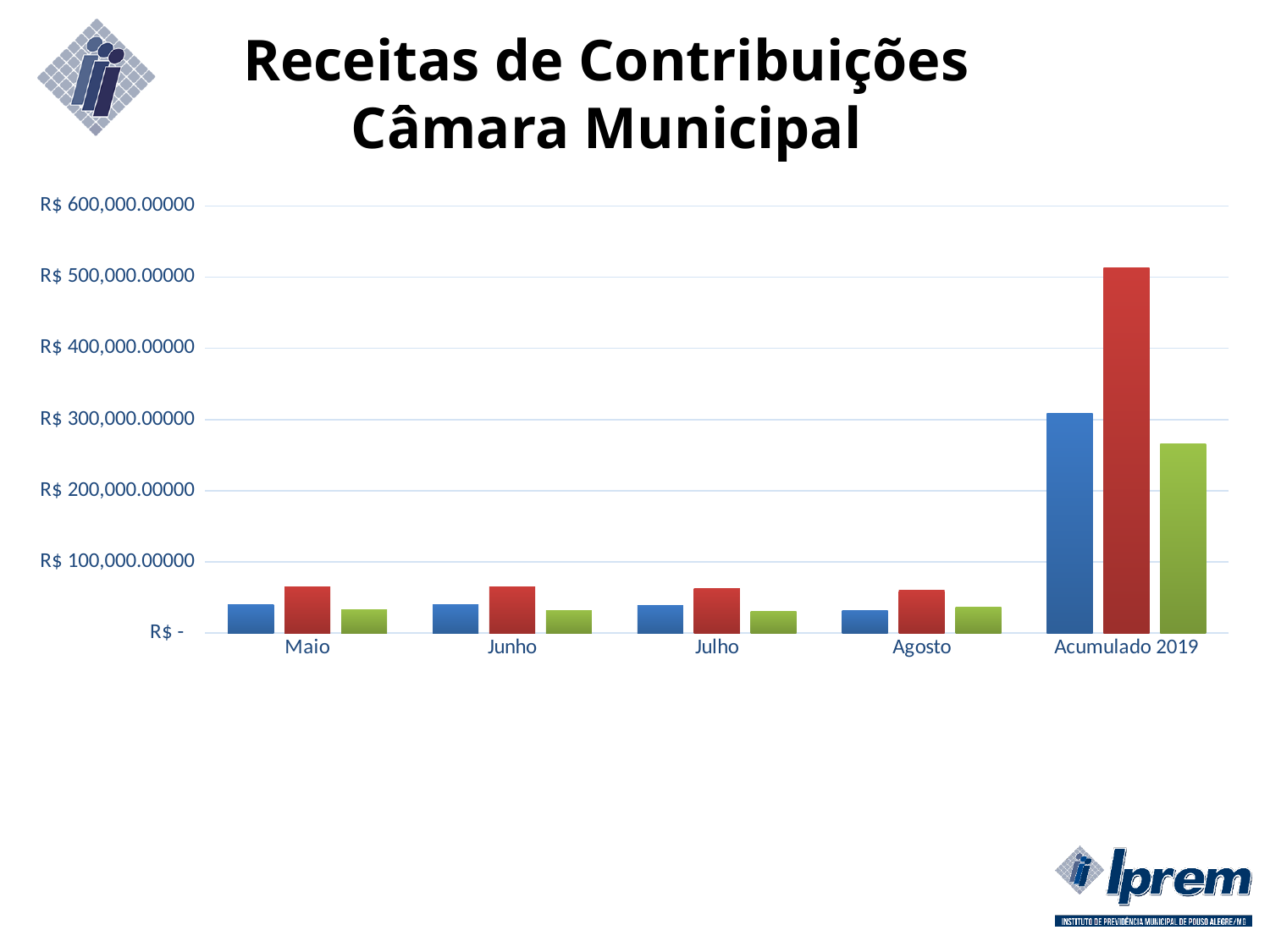
Is the value of the blue bar for Acumulado 2019 greater or less than R$ 200,000.00000? greater Which category has the tallest bars on the chart? Acumulado 2019 How many categories are shown on the x axis of the chart? 5 What is the title of the slide containing the chart? Receitas de Contribuições Câmara Municipal For Junho, which of the three bars is the tallest? the red bar Is the value of the red bar for Maio greater or less than R$ 100,000.00000? less Is the value of the green bar for Acumulado 2019 greater or less than R$ 300,000.00000? less What is the highest value labelled on the vertical axis of the chart? R$ 600,000.00000 What kind of chart is shown on the slide? bar chart How many bars are plotted for each category on the chart? 3 For Acumulado 2019, which bar is larger, the red bar or the blue bar? the red bar